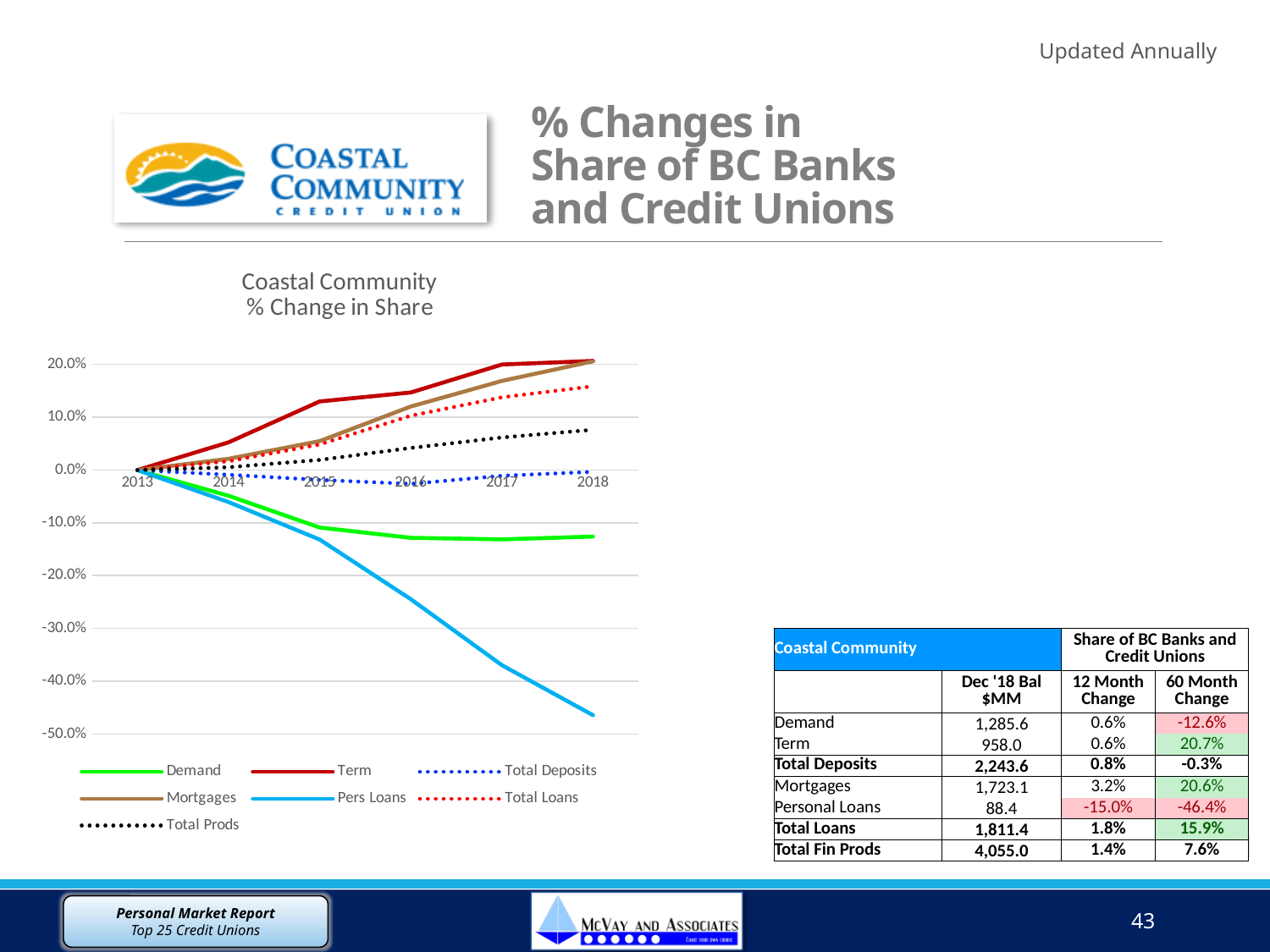
How many years are shown along the x axis of the chart? 6 In 2018, which is larger: Total Loans or Total Prods? Total Loans Is the value for Term in 2018 greater or less than 10.0%? greater Is the value for Demand in 2018 greater or less than -10.0%? less Is the value for Pers Loans in 2018 greater or less than -40.0%? less Which series has the lowest value in 2018? Pers Loans What is the value for Demand in 2013? 0.0% How many series does the chart legend list? 7 What is the title of the chart? Coastal Community % Change in Share Does the Pers Loans line rise or fall from 2013 to 2018? fall What kind of chart is shown on the slide? line chart